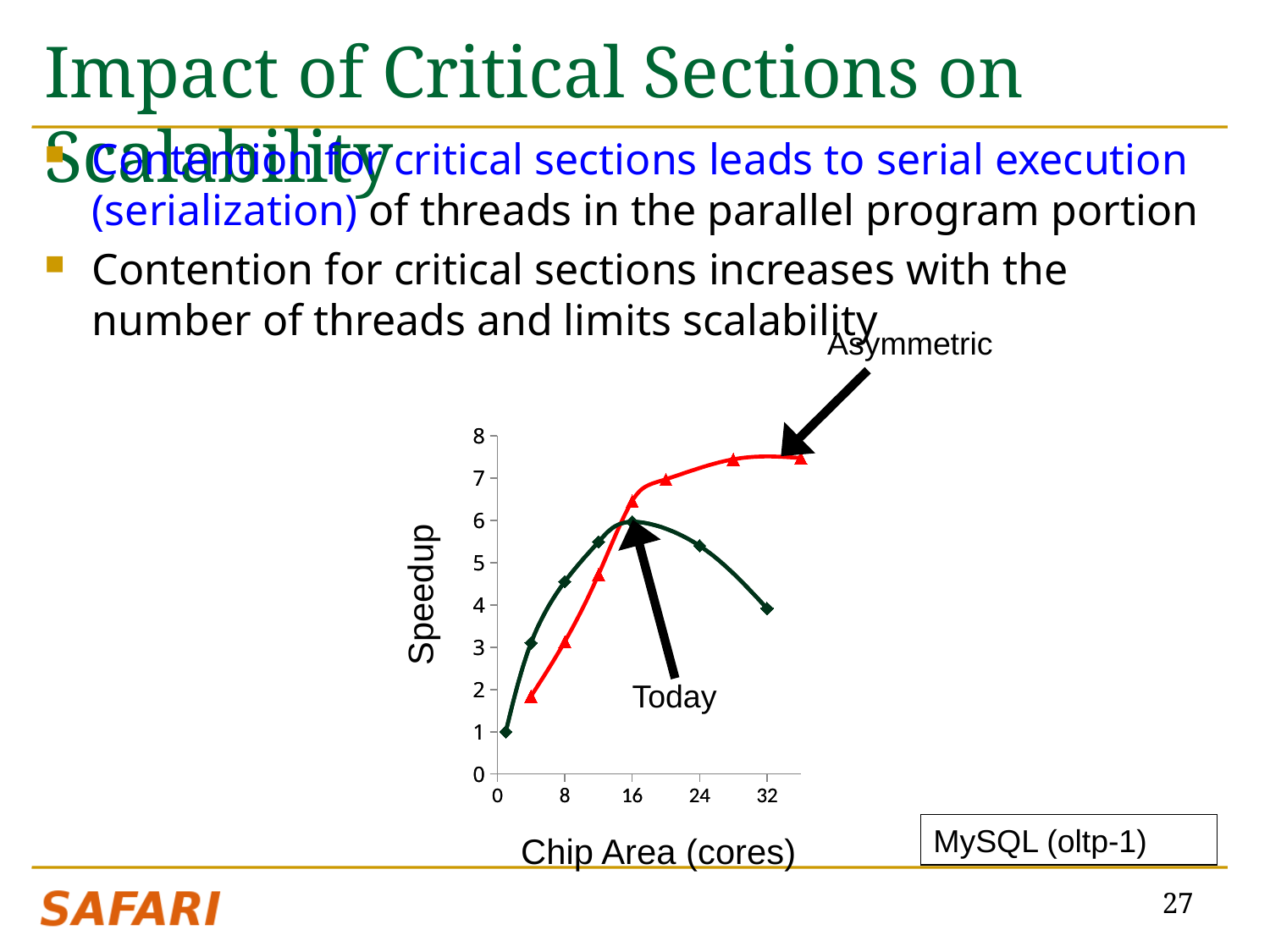
What is the label of the y axis of the chart? Speedup Is the speedup of the red (Asymmetric) line at 32 cores greater or less than 7? greater Is the speedup of the red (Asymmetric) line at 8 cores greater or less than 4? less What is the label of the x axis of the chart? Chip Area (cores) What kind of chart is shown on the slide? line chart Is the speedup of the green line at 32 cores greater or less than 5? less Does the speedup of the green line rise or fall between 16 and 32 cores? falls At 8 cores, which line has the higher speedup, the red (Asymmetric) line or the green line? the green line Does the speedup of the red (Asymmetric) line rise or fall as chip area increases? rises At 32 cores, which line has the higher speedup, the red (Asymmetric) line or the green line? the red (Asymmetric) line